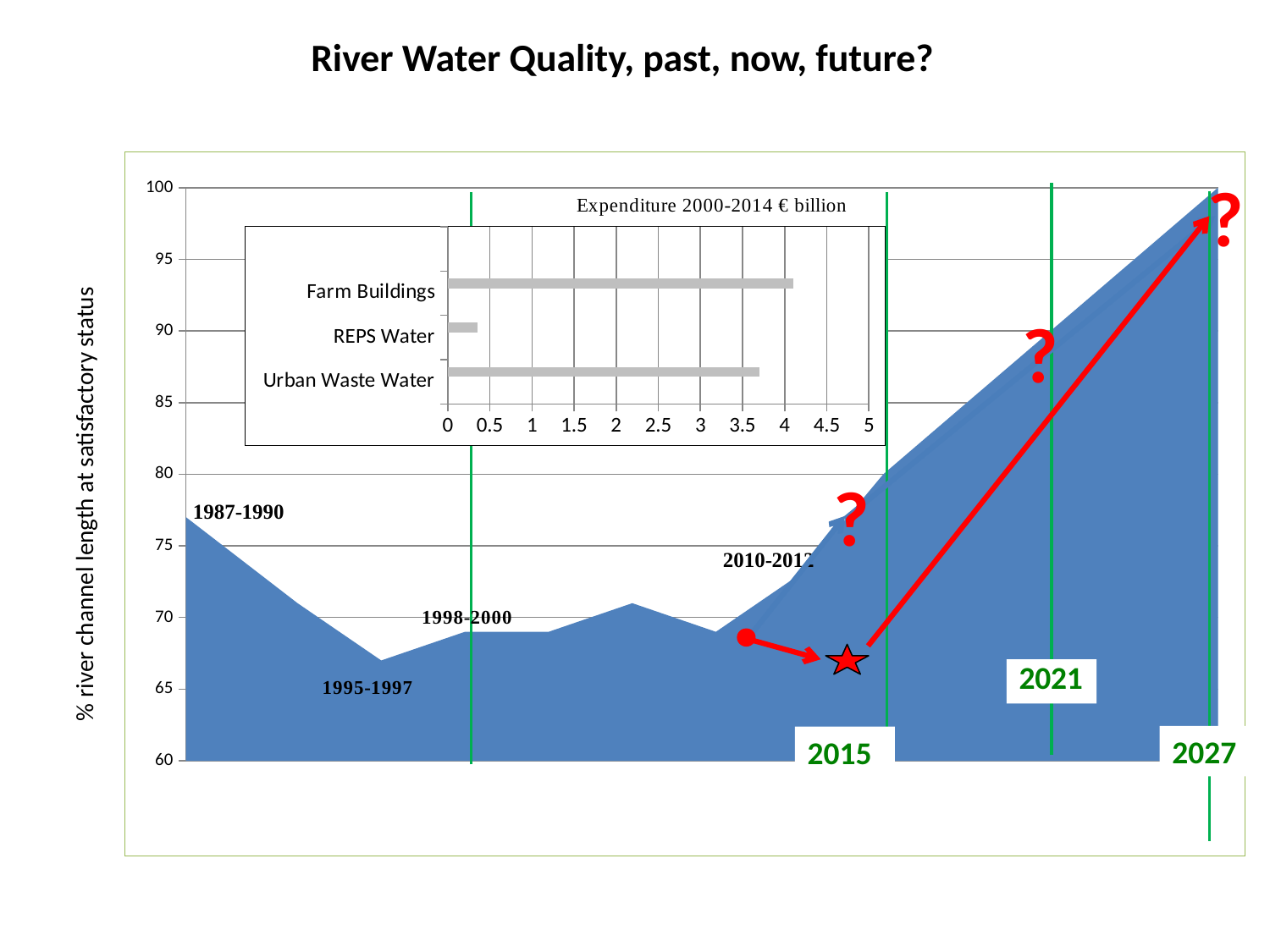
How many categories are shown in the inset chart 'Expenditure 2000-2014 € billion'? 3 In the inset chart 'Expenditure 2000-2014 € billion', is the value for Farm Buildings greater or less than 3.5? greater In the inset chart 'Expenditure 2000-2014 € billion', which category has the highest expenditure? Farm Buildings In the inset chart 'Expenditure 2000-2014 € billion', is the value for Urban Waste Water greater or less than 4? less In the inset chart 'Expenditure 2000-2014 € billion', which is larger, Farm Buildings or Urban Waste Water? Farm Buildings In the large river water quality chart, is the value for 1987-1990 greater or less than 75? greater What kind of chart is the inset 'Expenditure 2000-2014 € billion' chart? bar chart In the inset chart 'Expenditure 2000-2014 € billion', which category has the lowest expenditure? REPS Water What is the title of the inset chart? Expenditure 2000-2014 € billion In the large river water quality chart, does the value rise or fall from 1987-1990 to 1995-1997? fall What kind of chart is the large chart showing % river channel length at satisfactory status? area chart